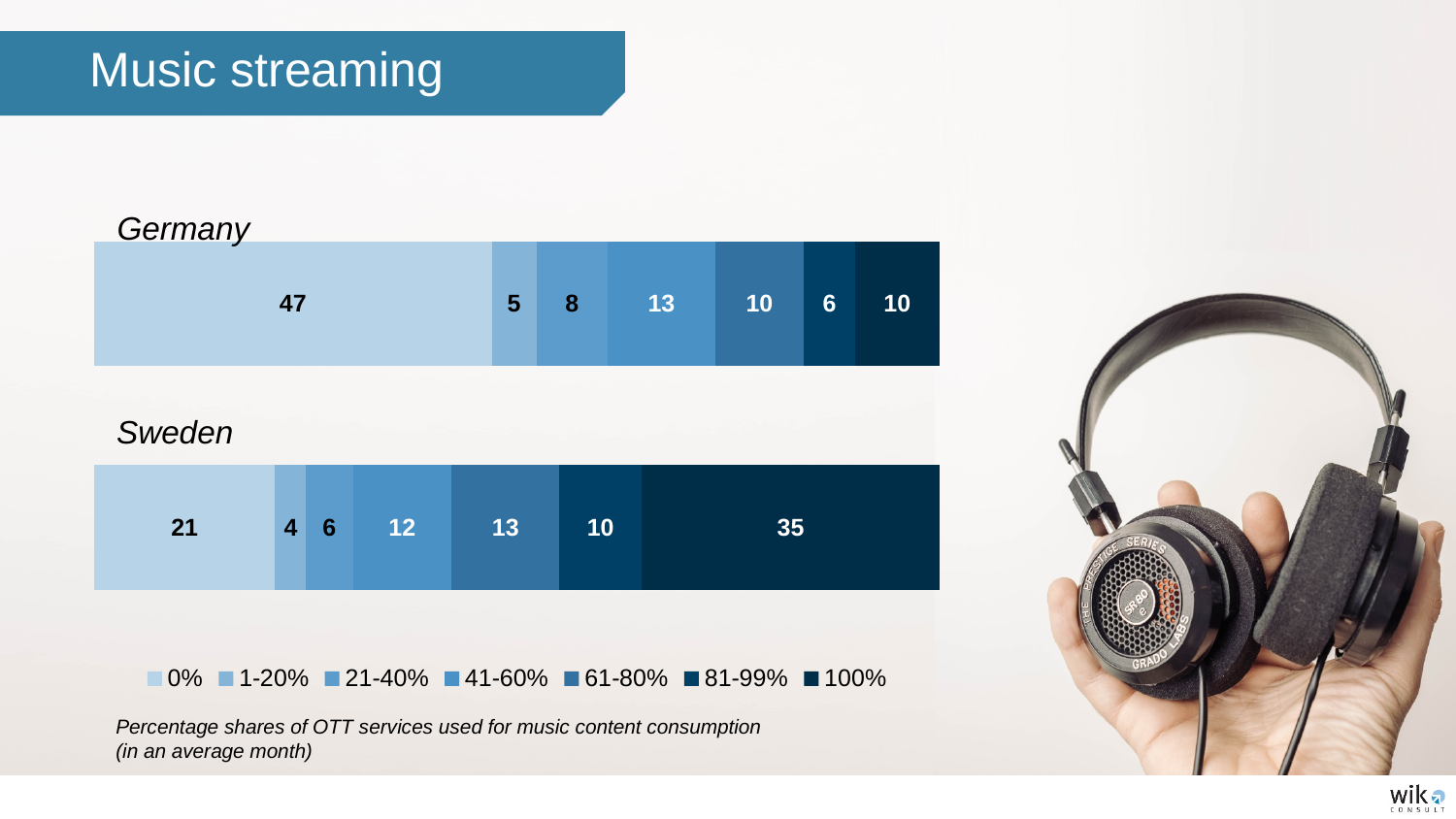
In the Sweden chart, what is the value for the 1-20% segment? 4 What kind of chart is used for Germany and Sweden? Stacked bar chart In the Germany chart, what is the value for the 0% segment? 47 In the Germany chart, which segment has the largest value? 0% Which is larger: the 100% segment in the Sweden chart or the 100% segment in the Germany chart? Sweden How many segments does the Germany stacked bar contain? 7 What is the difference between the 0% segment in the Germany chart and the 0% segment in the Sweden chart? 26 What is the total of the Sweden stacked bar? 101 In the Germany chart, what is the value for the 41-60% segment? 13 In the Sweden chart, what is the value for the 100% segment? 35 How many entries does the legend list? 7 In the Sweden chart, which segment has the smallest value? 1-20%